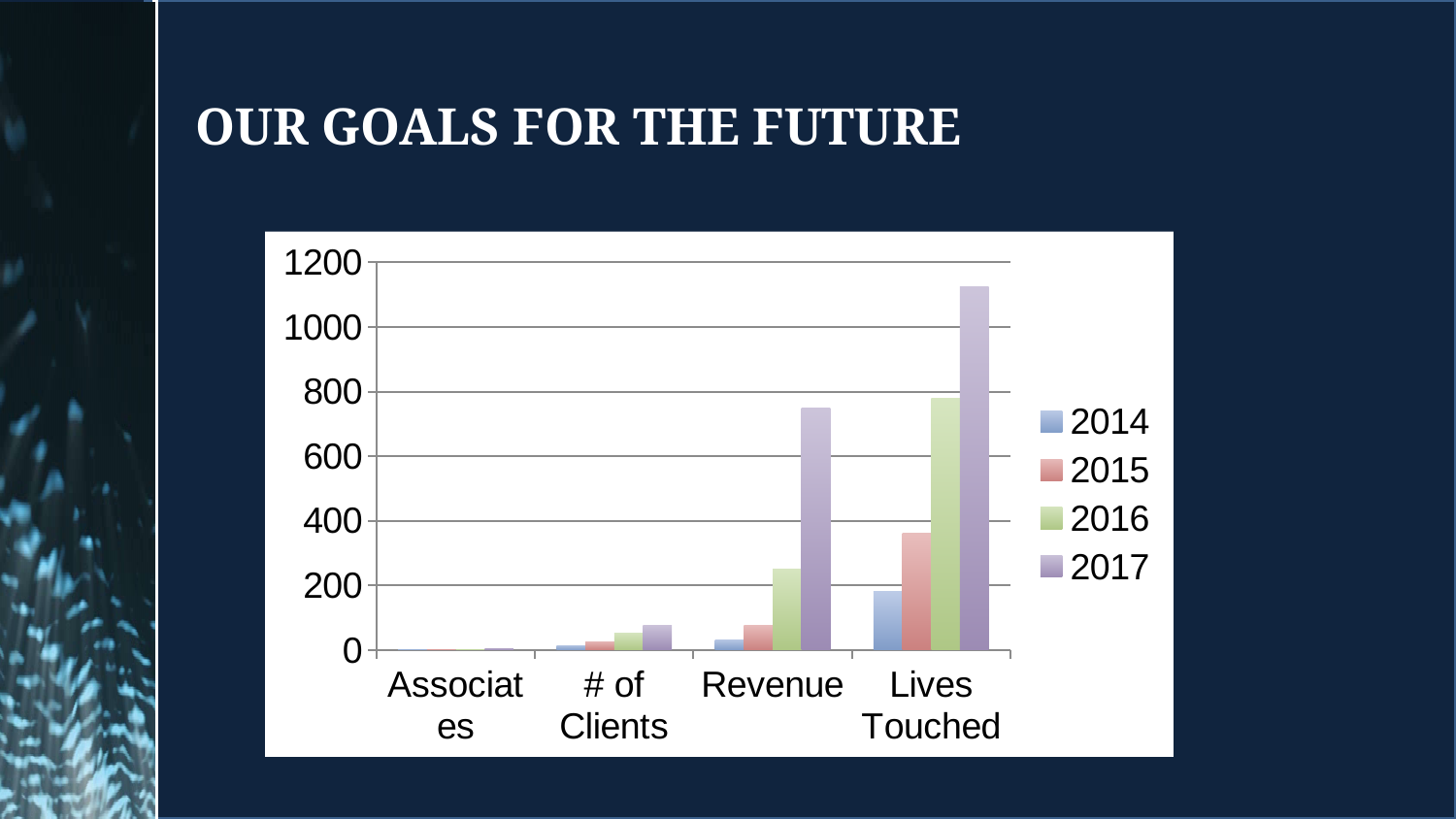
Is the 2017 value for Revenue greater or less than 600? greater What kind of chart is shown on the slide? bar chart What is the title of the slide containing the chart? OUR GOALS FOR THE FUTURE Which year is shown in purple in the legend? 2017 Is the 2017 value for Lives Touched greater or less than 1000? greater Which category has the lowest values across all years? Associates Which is larger for Lives Touched, the 2015 value or the 2016 value? 2016 How many series does the legend list? 4 Within the Revenue category, do the values rise or fall from 2014 to 2017? rise Is the 2016 value for Revenue greater or less than 400? less Which category has the tallest bar for 2017? Lives Touched How many categories are shown on the x axis? 4